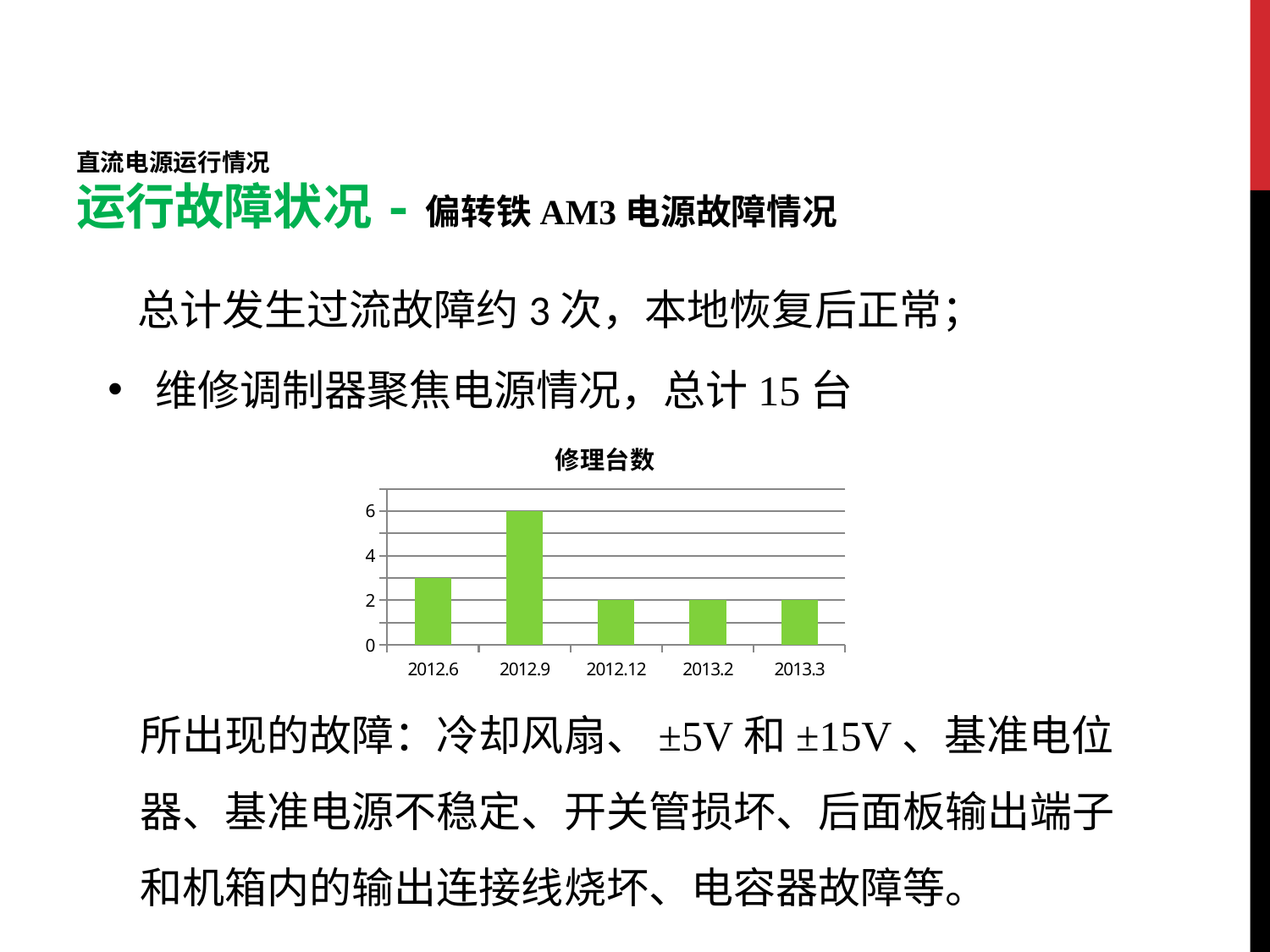
What is the value for 2012.12 in the chart? 2 What is the title of the chart? 修理台数 How many categories are shown on the x axis of the chart? 5 Which category has the highest value in the chart? 2012.9 What is the value for 2012.9 in the chart? 6 What type of chart is shown on the slide? bar chart Is the value for 2012.6 greater or less than 2? greater Does the value rise or fall from 2012.9 to 2012.12? fall Is the value for 2012.6 greater or less than 4? less What is the difference between the values for 2012.9 and 2013.2? 4 Which is larger, the value for 2012.6 or the value for 2012.12? 2012.6 What is the value for 2013.3 in the chart? 2